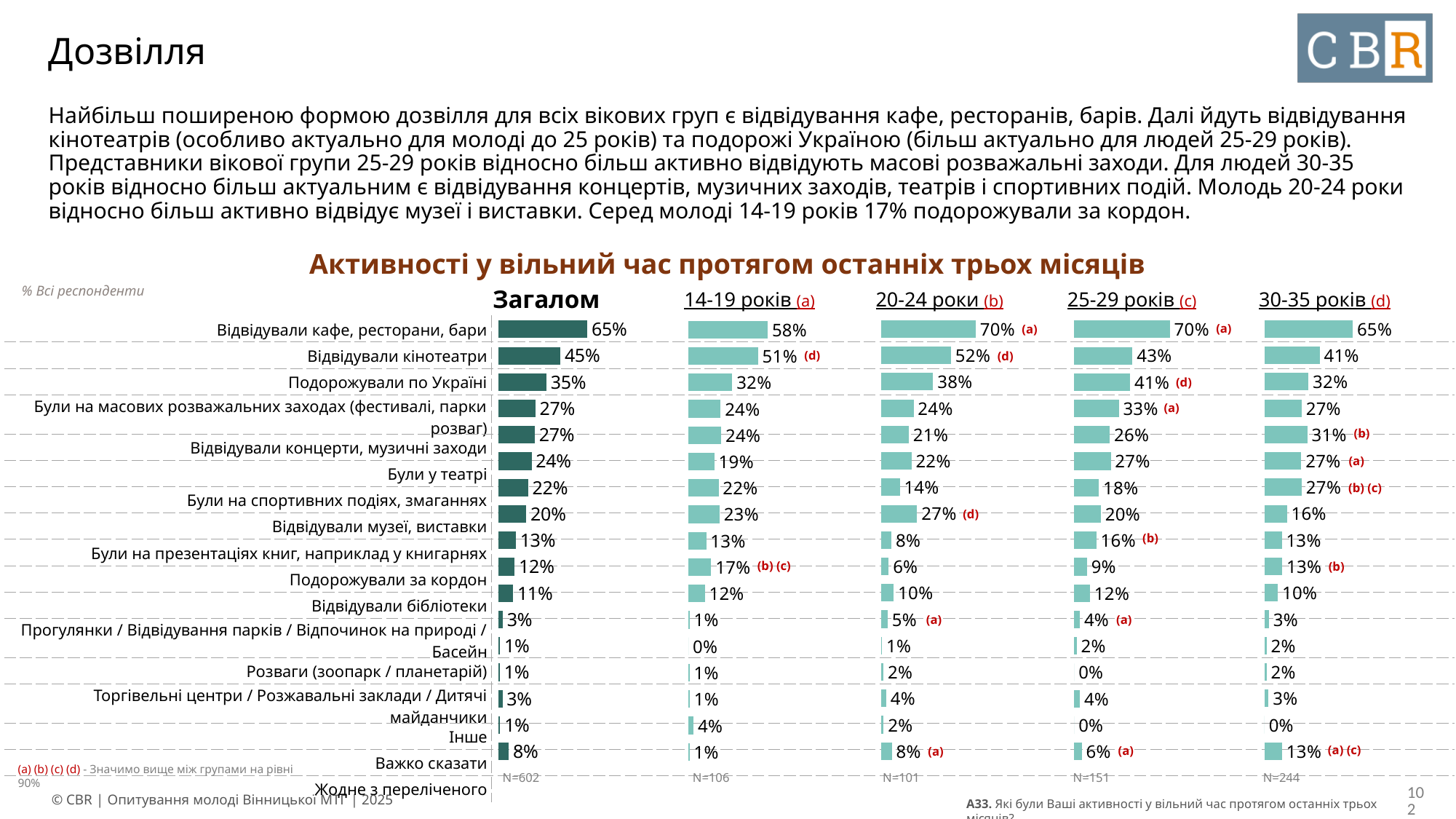
What is the difference between the 25-29 років and 20-24 роки values for 'Були на масових розважальних заходах (фестивалі, парки розваг)'? 9% What is the value for 'Подорожували по Україні' in the 25-29 років group? 41% What is the title of the chart? Активності у вільний час протягом останніх трьох місяців Which activity has the highest overall (Загалом) value? Відвідували кафе, ресторани, бари What type of chart is used on the slide? Bar chart What is the value for 'Відвідували кінотеатри' in the 14-19 років group? 51% How many age-group columns (excluding Загалом) are shown in the chart? 4 For 'Відвідували музеї, виставки', which group has the larger value: 20-24 роки or 30-35 років? 20-24 роки What is the value for 'Відвідували концерти, музичні заходи' in the 30-35 років group? 31% What is the difference between the overall values for 'Відвідували кафе, ресторани, бари' and 'Відвідували кінотеатри'? 20% What is the overall (Загалом) value for 'Відвідували кафе, ресторани, бари'? 65% What is the value for 'Подорожували за кордон' in the 14-19 років group? 17%